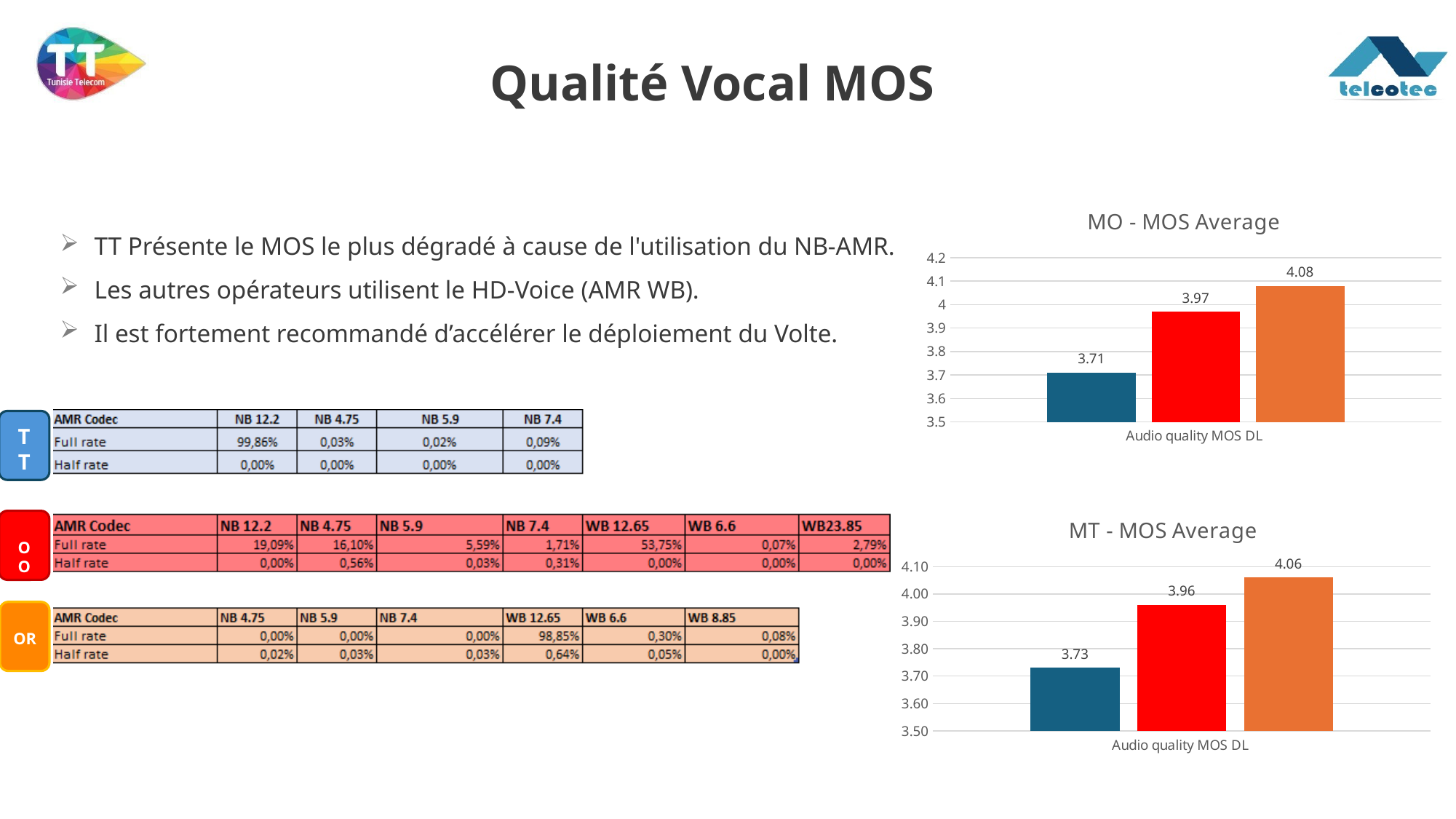
In the MT - MOS Average chart, what is the value of the blue bar? 3.73 In the MT - MOS Average chart, which is larger, the red bar or the orange bar? The orange bar In the MO - MOS Average chart, is the value of the red bar greater or less than 3.9? greater In the MT - MOS Average chart, which bar has the lowest value? The blue bar (3.73) How many bars are plotted in the MT - MOS Average chart? 3 In the MO - MOS Average chart, what is the difference between the orange bar and the blue bar? 0.37 In the MO - MOS Average chart, what is the value of the blue bar? 3.71 In the MO - MOS Average chart, which bar has the highest value? The orange bar (4.08) In the MT - MOS Average chart, what is the value of the red bar? 3.96 In the MO - MOS Average chart, what is the value of the orange bar? 4.08 What type of chart is the MO - MOS Average chart? Bar chart In the MT - MOS Average chart, what is the difference between the red bar and the blue bar? 0.23